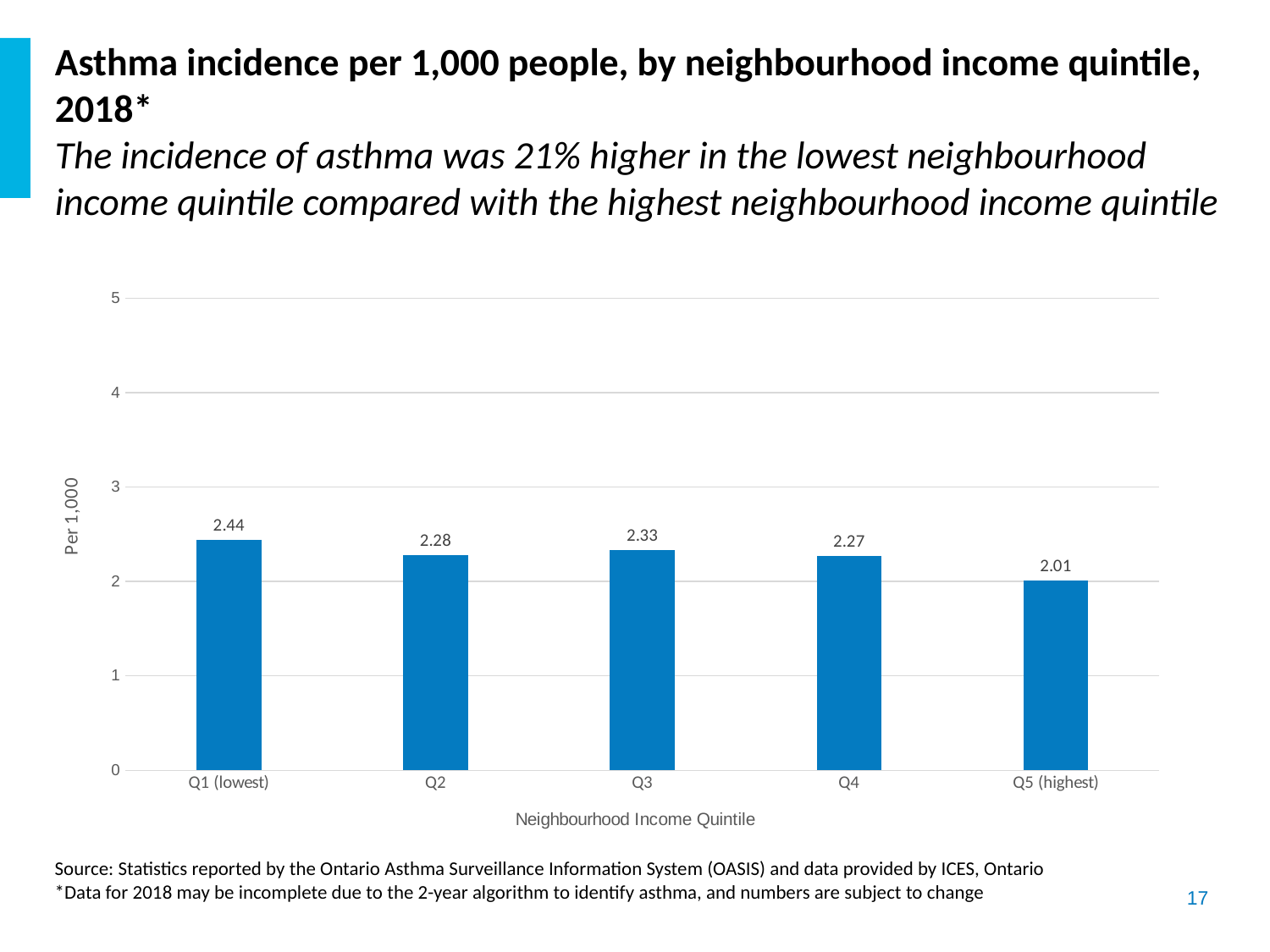
How many neighbourhood income quintiles are shown on the chart? 5 What is the difference in asthma incidence per 1,000 people between Q1 (lowest) and Q5 (highest)? 0.43 What is the asthma incidence per 1,000 people for Q5 (highest)? 2.01 What kind of chart is shown on the slide? Bar chart Which neighbourhood income quintile has the lowest asthma incidence? Q5 (highest) Which has a higher asthma incidence, Q2 or Q3? Q3 What is the asthma incidence per 1,000 people for Q3? 2.33 What is the asthma incidence per 1,000 people for Q1 (lowest)? 2.44 Is the asthma incidence for Q4 greater or less than 3? less Which neighbourhood income quintile has the highest asthma incidence? Q1 (lowest) What is the label of the x axis? Neighbourhood Income Quintile What is the label of the y axis? Per 1,000